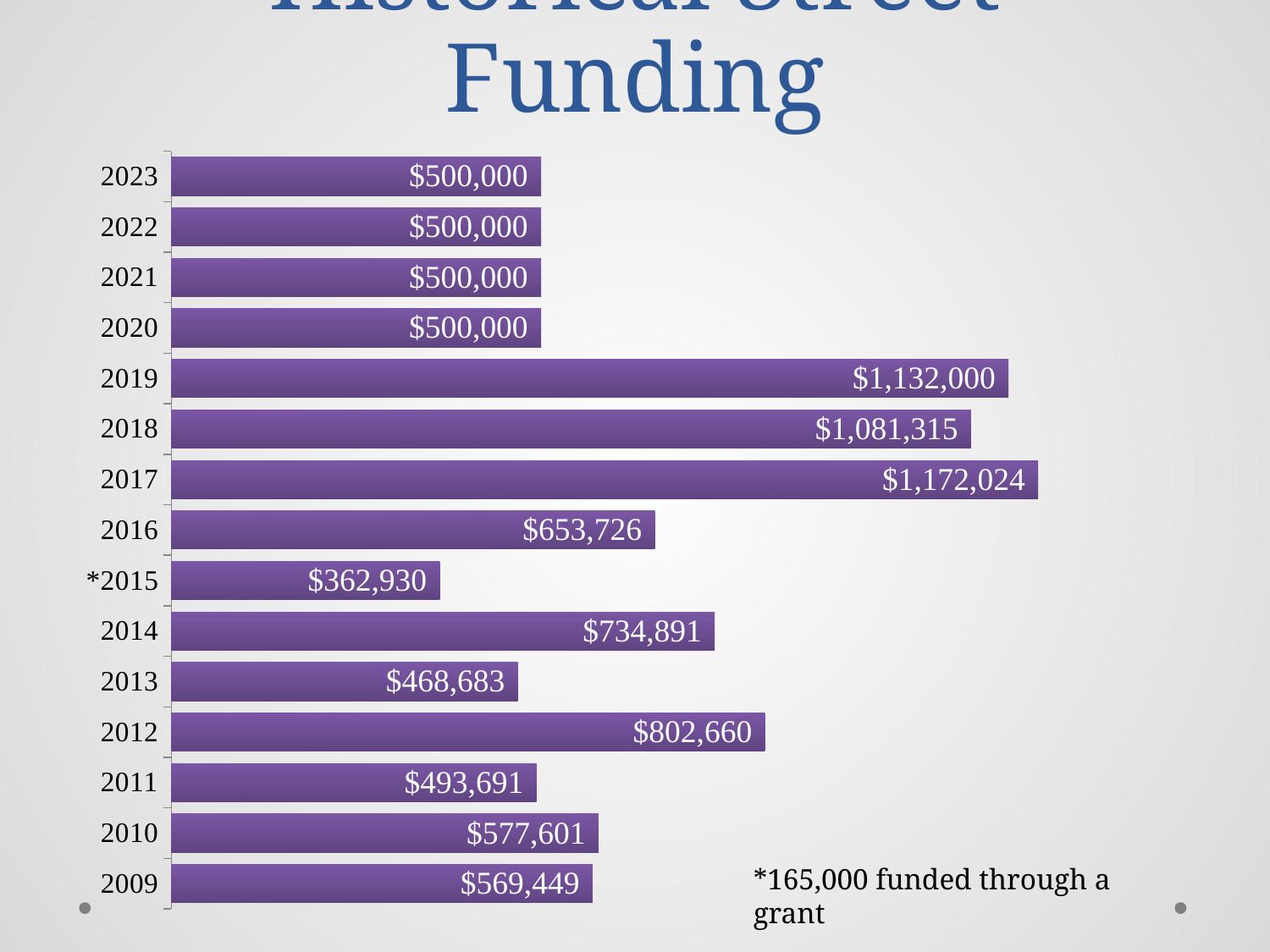
Which year has the highest funding value? 2017 What is the funding value for 2019? $1,132,000 What is the difference between the funding values for 2017 and 2018? $90,709 What kind of chart is shown on the slide? Bar chart Which year has the lowest funding value? 2015 What is the funding value for 2013? $468,683 How many years are shown in the chart? 15 What is the difference between the funding values for 2014 and 2013? $266,208 Which year is marked with an asterisk in the chart? 2015 Which year has a larger funding value, 2012 or 2016? 2012 What funding value is shown for each of the years 2020 through 2023? $500,000 What is the funding value for 2009? $569,449